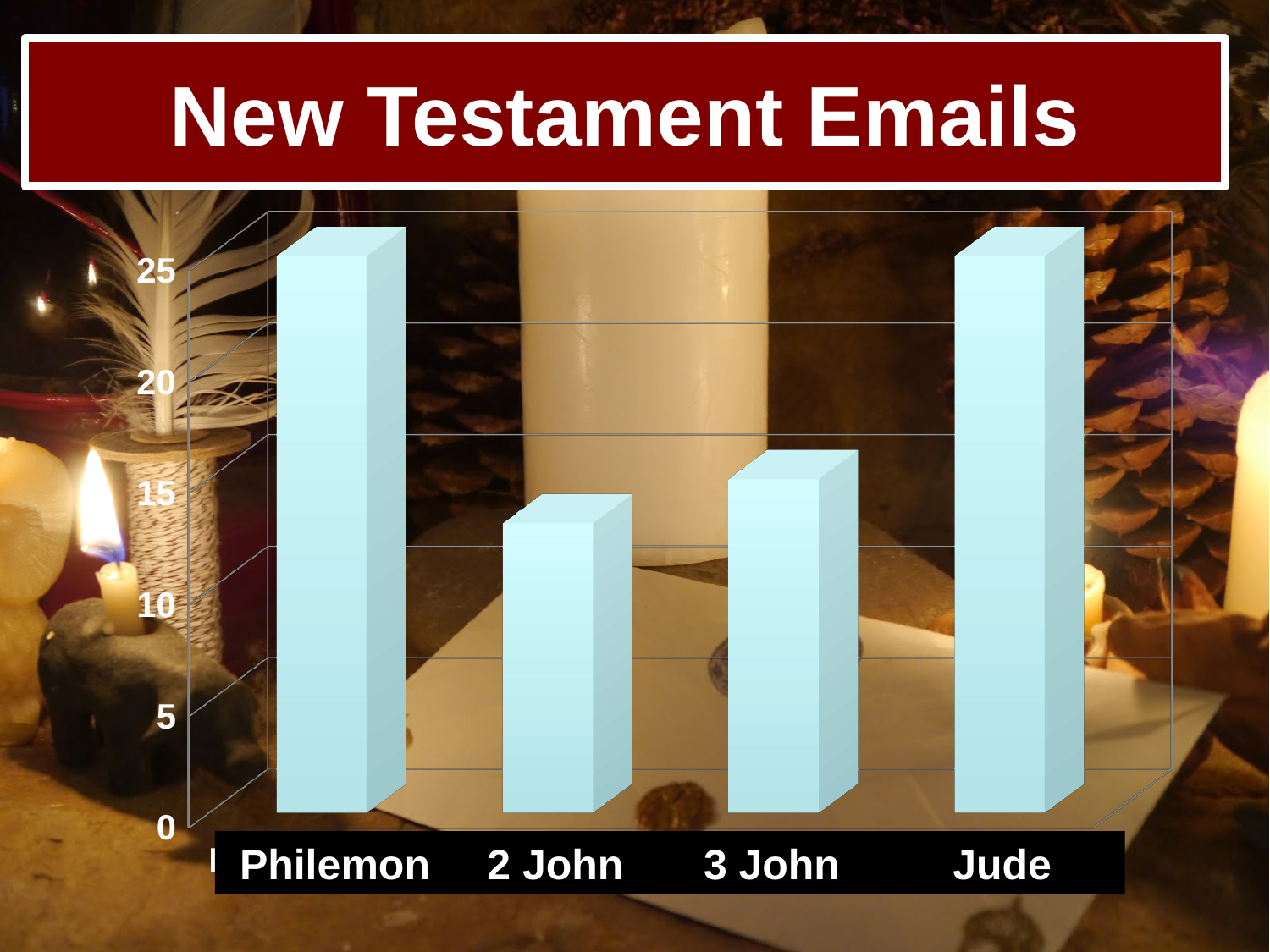
Is the value for Philemon greater or less than 20? greater Is the value for Jude greater or less than 20? greater Which is larger, the value for 2 John or the value for 3 John? 3 John Is the value for 2 John greater or less than 10? greater Which category has the lowest value? 2 John What is the highest value shown on the vertical axis? 25 What kind of chart is shown on the slide? bar chart How many categories are plotted on the chart? 4 What is the title of the slide? New Testament Emails